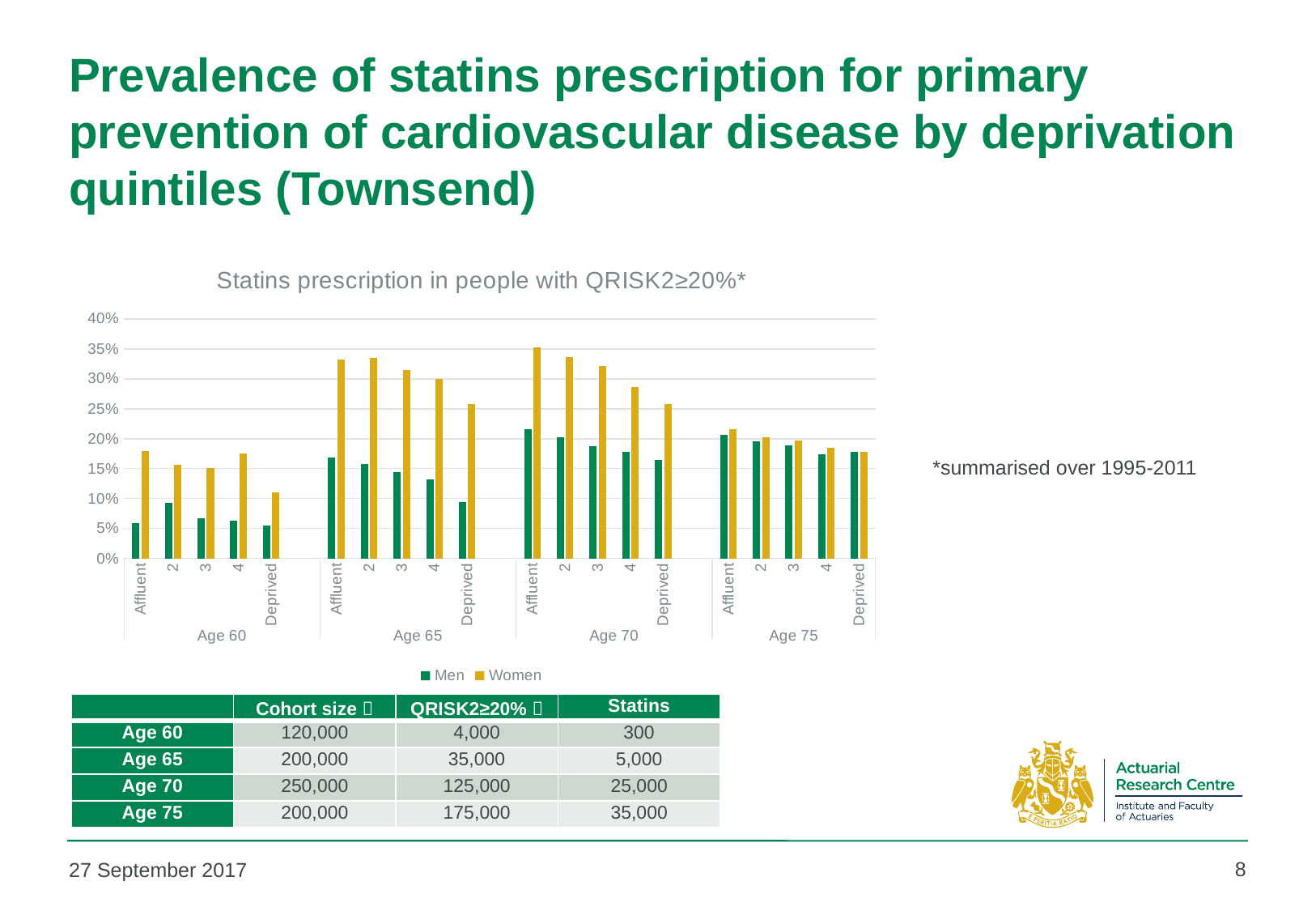
Is the value for Women in the Affluent category at Age 70 greater or less than 30%? greater How many series does the chart legend list? 2 Within the Age 70 group, do the Women values rise or fall moving from Affluent to Deprived? Fall What kind of chart is shown on the slide? Bar chart How many age groups are shown along the x axis of the chart? 4 How many deprivation categories are shown within each age group on the chart? 5 What is the title of the chart? Statins prescription in people with QRISK2≥20%* Is the value for Men in the Affluent category at Age 60 greater or less than 10%? less Is the value for Men in the Deprived category at Age 70 greater or less than 20%? less What are the two series named in the chart legend? Men and Women At Age 65, which is larger for the Affluent category: the value for Men or the value for Women? Women